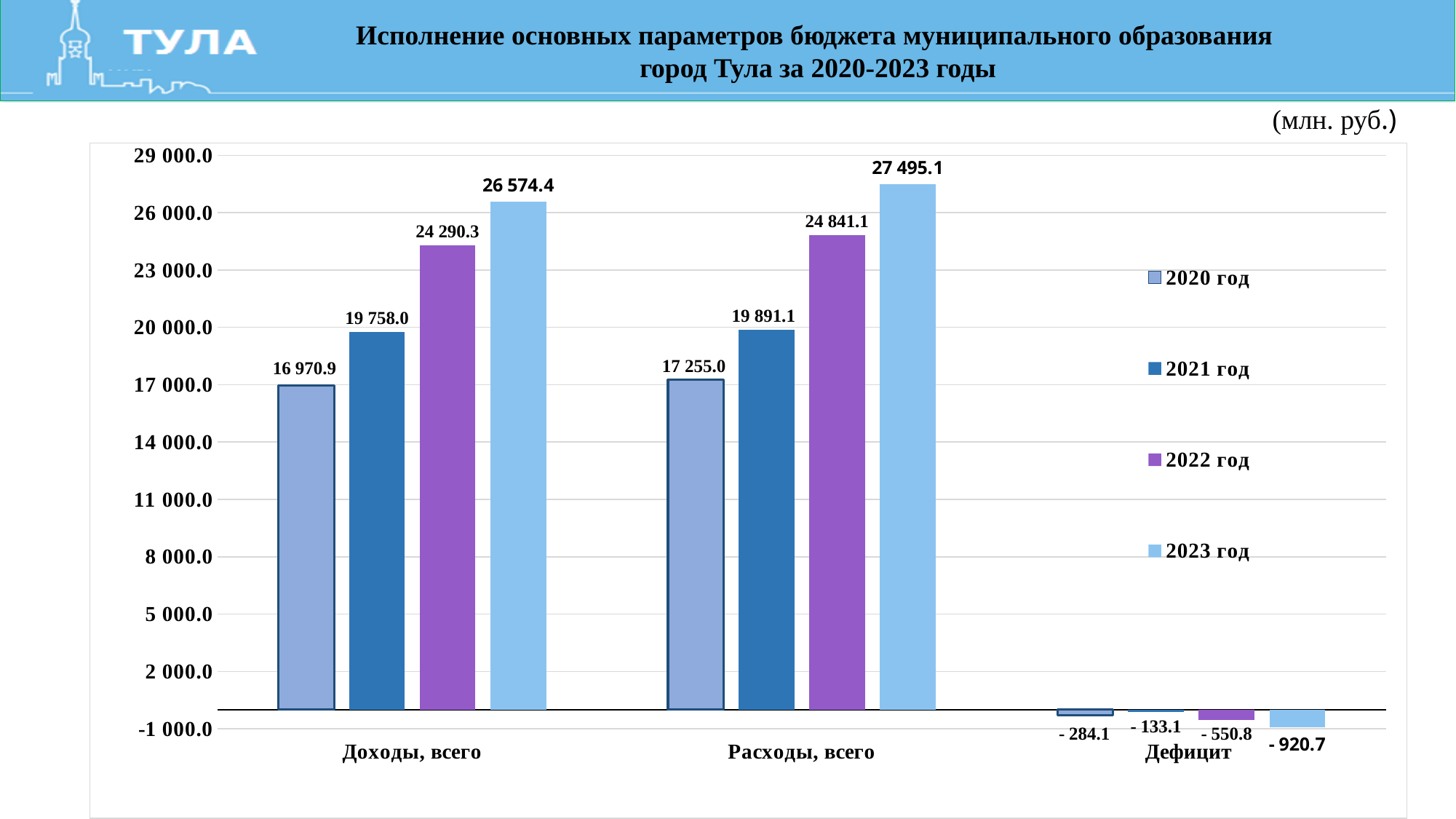
Which year has the lowest value for Доходы, всего? 2020 год What type of chart is shown on the slide? bar chart What is the value for Доходы, всего in 2020 год? 16 970.9 What is the value for Расходы, всего in 2023 год? 27 495.1 Which year has the highest value for Расходы, всего? 2023 год What is the difference between Расходы, всего and Доходы, всего in 2023 год? 920.7 Do the values for Доходы, всего rise or fall from 2020 год to 2023 год? rise How many categories are shown on the x axis? 3 What is the value for Доходы, всего in 2022 год? 24 290.3 How many series does the legend list? 4 Which is larger: Доходы, всего in 2021 год or Расходы, всего in 2021 год? Расходы, всего What is the value for Дефицит in 2021 год? - 133.1